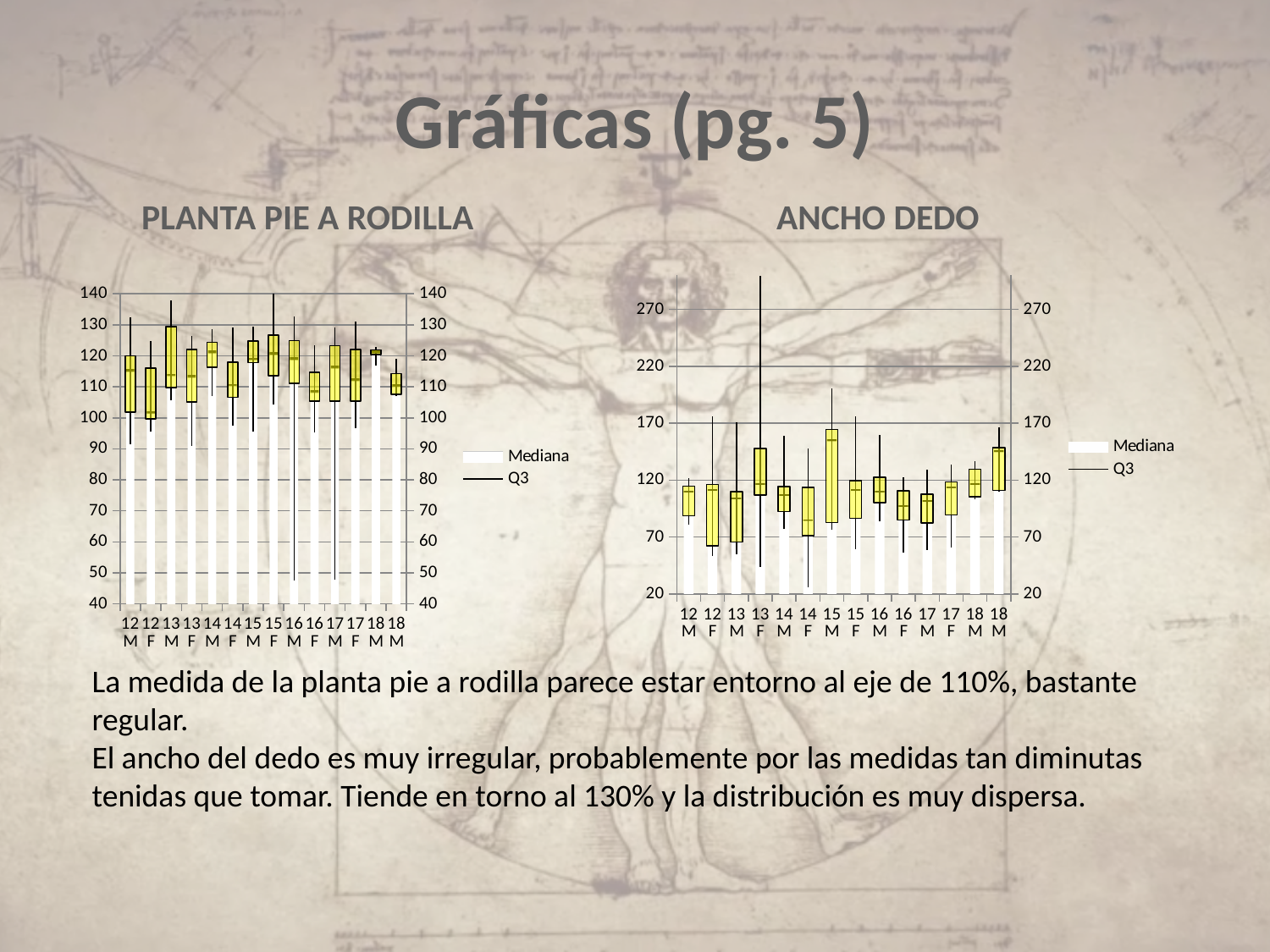
How many entries does the legend of the ANCHO DEDO chart list? 2 In the ANCHO DEDO chart, is the top of the upper whisker for 15 M greater or less than 170? greater What is the title of the chart on the left of the slide? PLANTA PIE A RODILLA In the PLANTA PIE A RODILLA chart, is the top of the upper whisker for 13 M greater or less than 130? greater What kind of chart is the PLANTA PIE A RODILLA chart? box plot How many categories are shown on the x axis of the ANCHO DEDO chart? 14 In the ANCHO DEDO chart, is the bottom of the lower whisker for 14 F greater or less than 70? less What are the two legend entries on the PLANTA PIE A RODILLA chart? Mediana and Q3 How many categories are shown on the x axis of the PLANTA PIE A RODILLA chart? 14